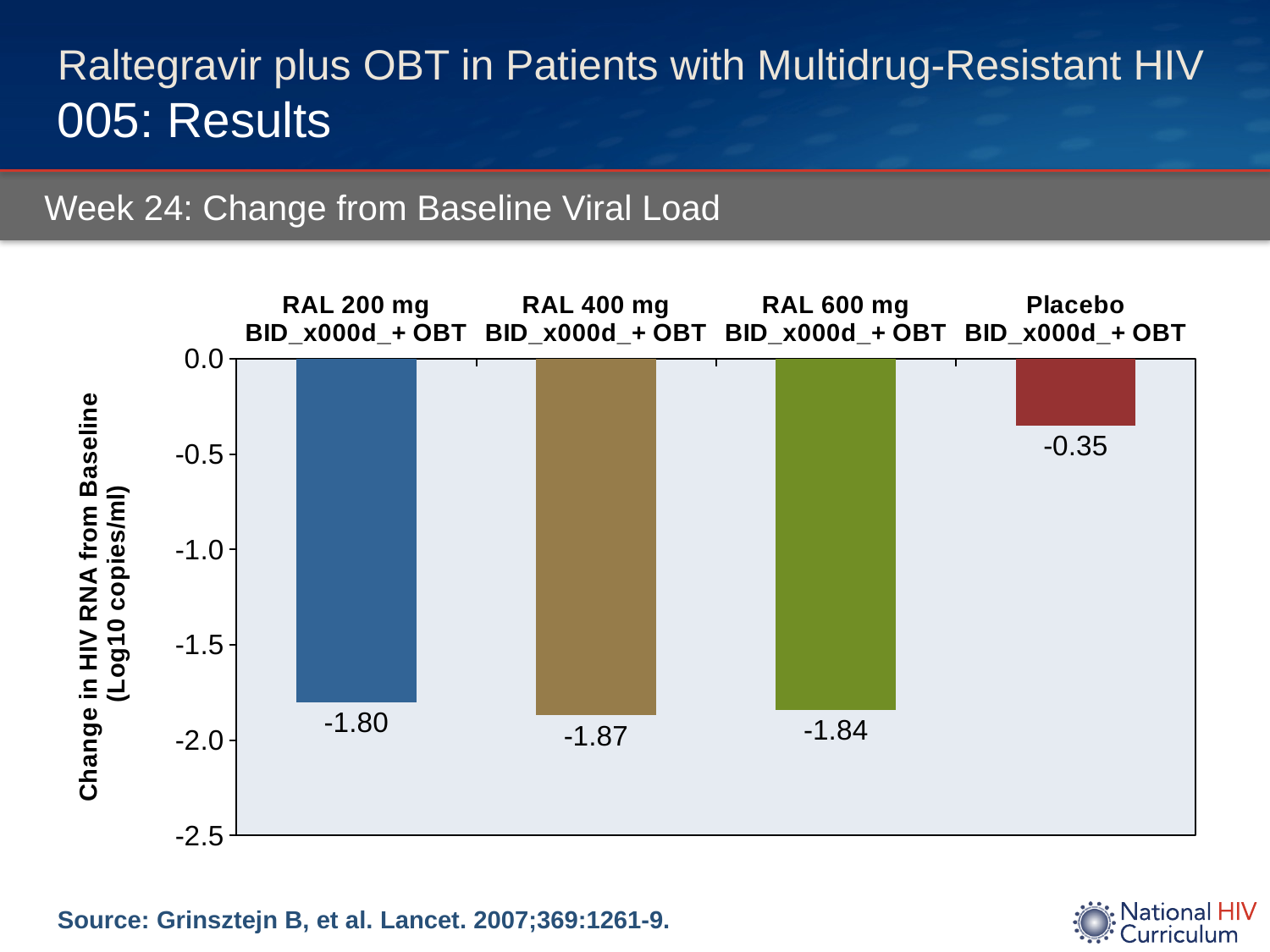
What is the change in HIV RNA from baseline for RAL 600 mg BID + OBT? -1.84 Which group has a larger decrease in HIV RNA from baseline, RAL 200 mg BID + OBT or Placebo + OBT? RAL 200 mg BID + OBT What is the difference between the change from baseline for RAL 200 mg BID + OBT and RAL 600 mg BID + OBT? 0.04 What kind of chart is shown on the slide? Bar chart What is the change in HIV RNA from baseline for RAL 400 mg BID + OBT? -1.87 What is the change in HIV RNA from baseline for Placebo + OBT? -0.35 What is the change in HIV RNA from baseline for RAL 200 mg BID + OBT? -1.80 Which group shows the smallest decrease in HIV RNA from baseline? Placebo + OBT What is the y-axis label of the chart? Change in HIV RNA from Baseline (Log10 copies/ml) What is the difference between the change from baseline for RAL 400 mg BID + OBT and Placebo + OBT? 1.52 Which group shows the largest decrease in HIV RNA from baseline? RAL 400 mg BID + OBT How many treatment groups are shown in the chart? 4